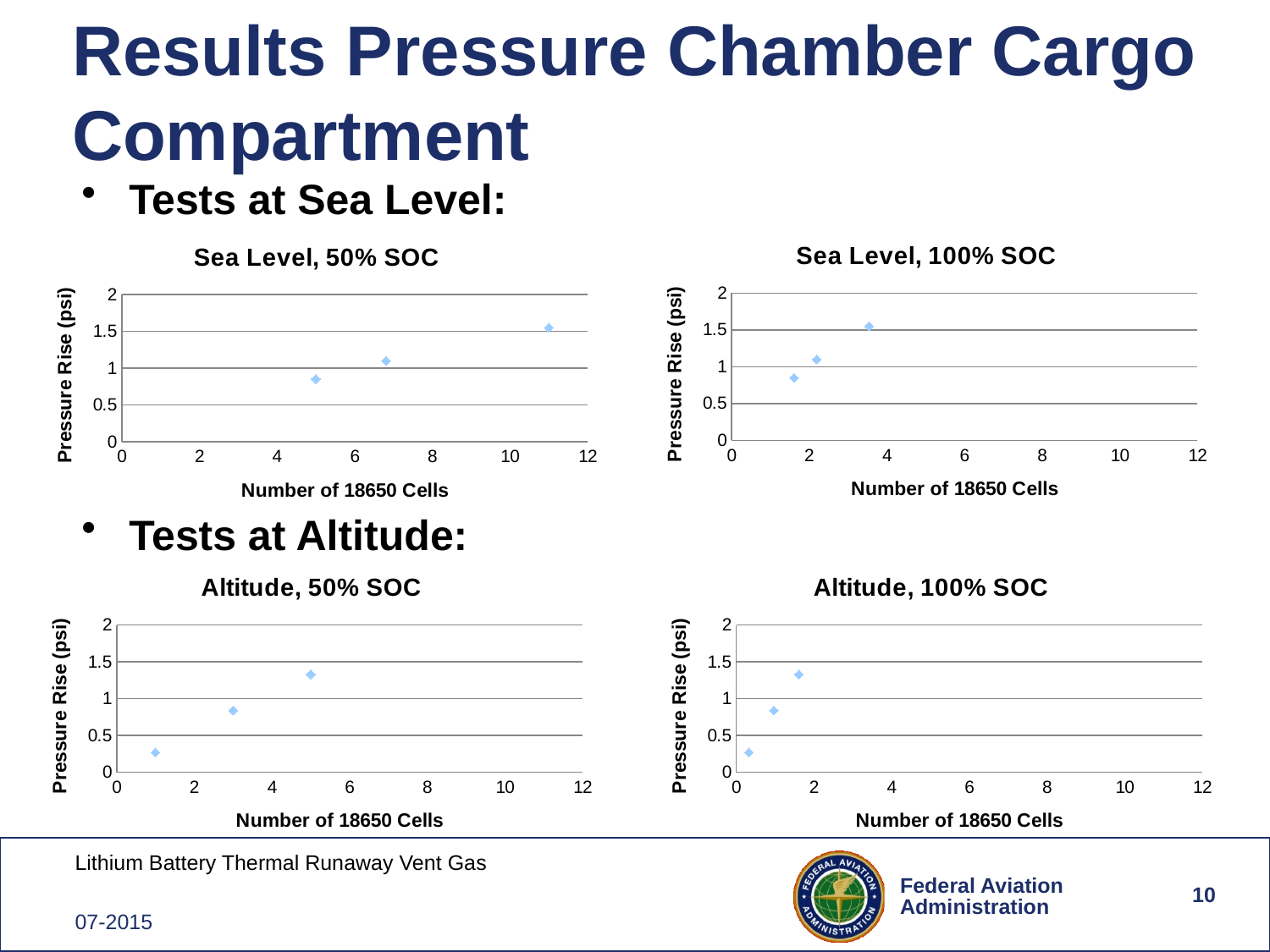
What is the x-axis label of the "Sea Level, 100% SOC" chart? Number of 18650 Cells How many data points are plotted in the "Sea Level, 50% SOC" chart? 3 What kind of chart is the "Sea Level, 50% SOC" chart? scatter chart What is the y-axis label of the "Altitude, 50% SOC" chart? Pressure Rise (psi) In the "Sea Level, 50% SOC" chart, is the pressure rise for the point with the most cells greater or less than 1 psi? greater In the "Altitude, 50% SOC" chart, is the pressure rise for the point with the fewest cells greater or less than 0.5 psi? less In the "Sea Level, 100% SOC" chart, do the pressure rise values rise or fall as the number of cells increases? rise How many charts are shown on the slide? 4 In the "Altitude, 50% SOC" chart, do the pressure rise values rise or fall as the number of cells increases? rise In the "Sea Level, 100% SOC" chart, is the pressure rise for the point with the fewest cells greater or less than 0.5 psi? greater How many data points are plotted in the "Altitude, 100% SOC" chart? 3